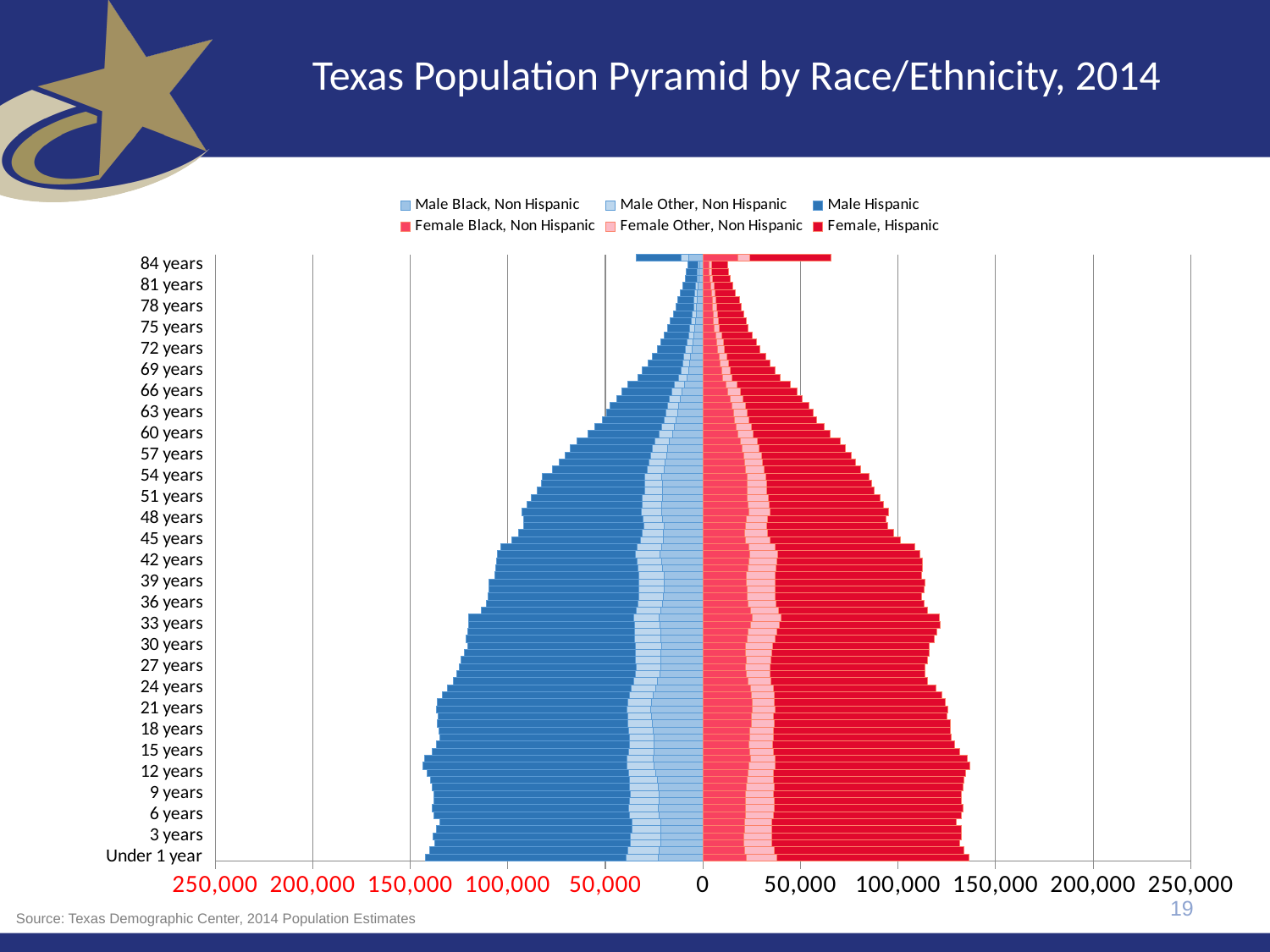
Is the total male bar for 12 years greater or less than 100,000? greater How many series does the legend list? 6 Is the total female bar for 33 years greater or less than 100,000? greater Moving from 84 years down to Under 1 year, do the total bar lengths generally rise or fall? rise Which legend entry is shown in the darkest red colour? Female, Hispanic Is the total male bar for 75 years greater or less than 50,000? less What kind of chart is shown on the slide? bar chart Which is larger, the total male bar for 12 years or the total male bar for 60 years? 12 years Which is larger at 84 years, the total male bar or the total female bar? female What is the title of the chart? Texas Population Pyramid by Race/Ethnicity, 2014